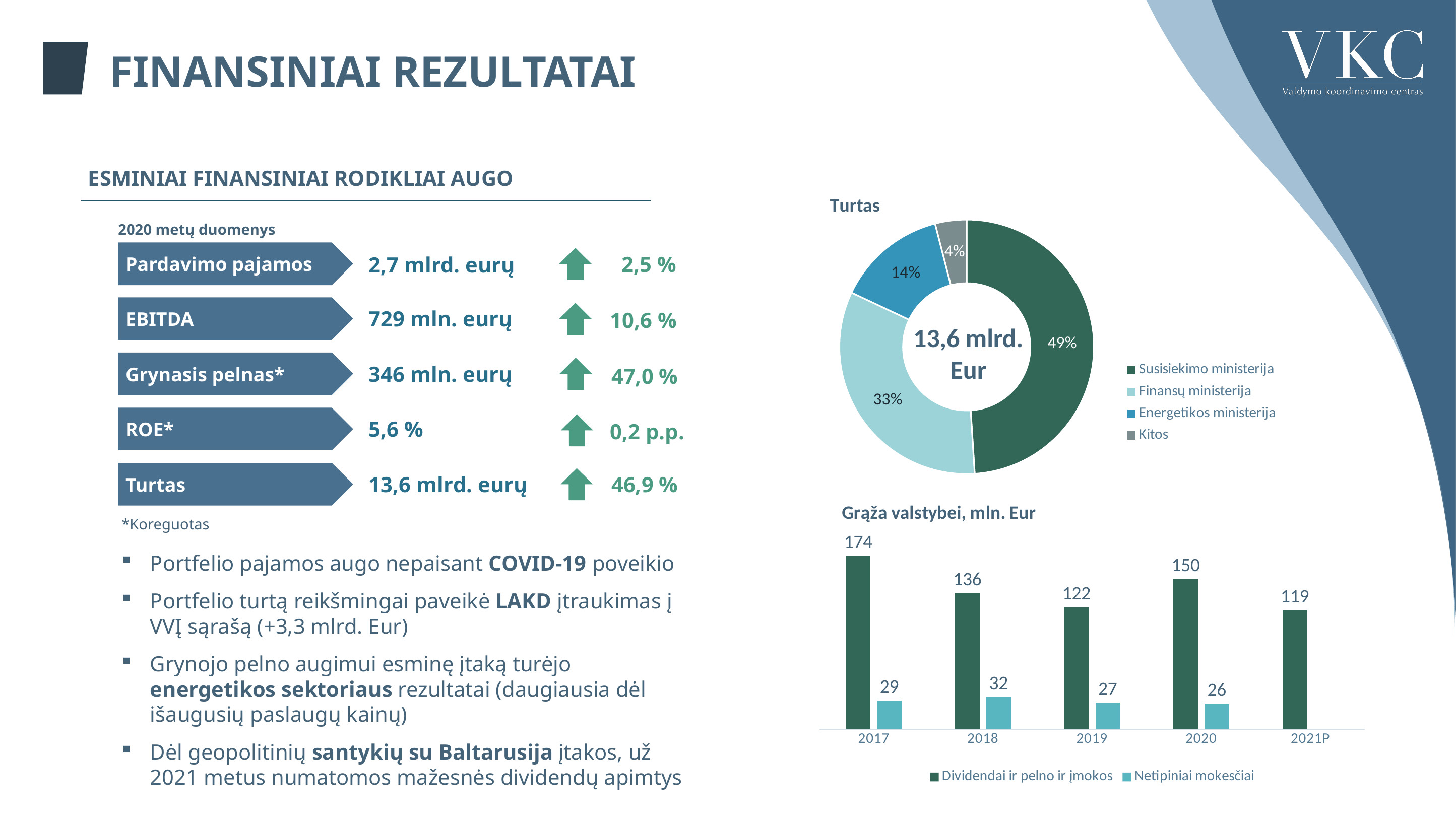
What kind of chart is the 'Grąža valstybei, mln. Eur' chart? Bar chart In the 'Grąža valstybei, mln. Eur' chart, which is larger: Netipiniai mokesčiai in 2018 or in 2019? 2018 What kind of chart is the 'Turtas' chart? Doughnut (pie) chart In the 'Turtas' chart, what share of assets belongs to Finansų ministerija? 33% In the 'Grąža valstybei, mln. Eur' chart, what is the value of Dividendai ir pelno ir įmokos for 2017? 174 In the 'Turtas' chart, which category has the smallest share? Kitos In the 'Grąža valstybei, mln. Eur' chart, what is the difference between Dividendai ir pelno ir įmokos in 2020 and 2019? 28 In the 'Turtas' chart, how many categories does the legend list? 4 In the 'Grąža valstybei, mln. Eur' chart, how many series does the legend list? 2 In the 'Grąža valstybei, mln. Eur' chart, what is the value of Netipiniai mokesčiai for 2020? 26 In the 'Turtas' chart, what share of assets belongs to Susisiekimo ministerija? 49% In the 'Grąža valstybei, mln. Eur' chart, which year has the highest value for Dividendai ir pelno ir įmokos? 2017